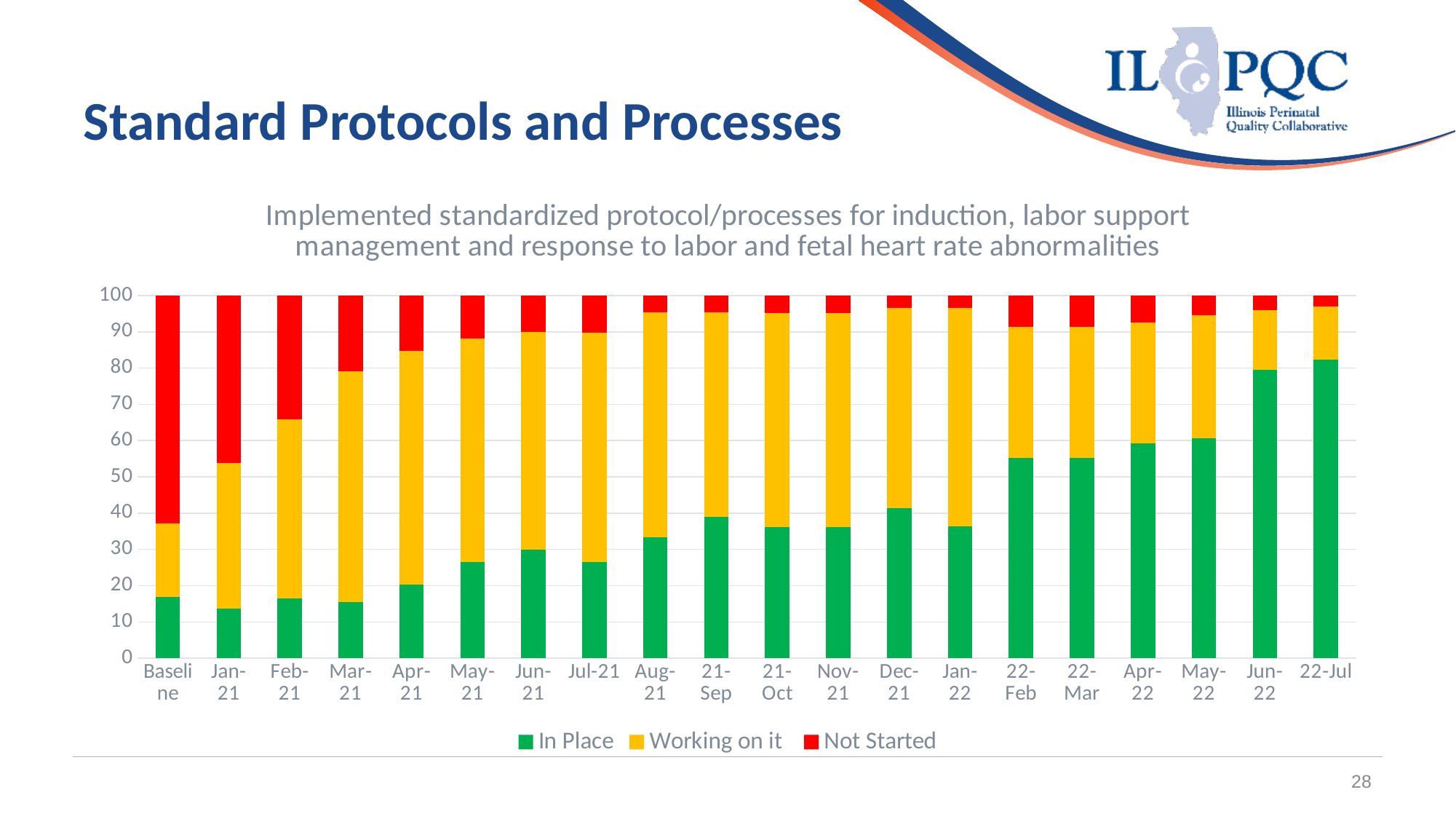
How many series does the legend list? 3 Does the Not Started share rise or fall from Baseline to 22-Jul? Fall Which has a larger In Place value, Jan-22 or 22-Feb? 22-Feb What kind of chart is shown on the slide? Stacked bar chart How many time-period categories are plotted along the x axis? 20 What is the total height of the stacked bar for Baseline, as read from the y axis? 100 Which category has the largest Not Started segment? Baseline Which series is shown in green in the legend? In Place Which has a larger Not Started segment, Jan-21 or Feb-21? Jan-21 Is the In Place value for Jun-22 greater or less than 70? greater Does the In Place share rise or fall from Baseline to 22-Jul? Rise Is the In Place value for Baseline greater or less than 20? less